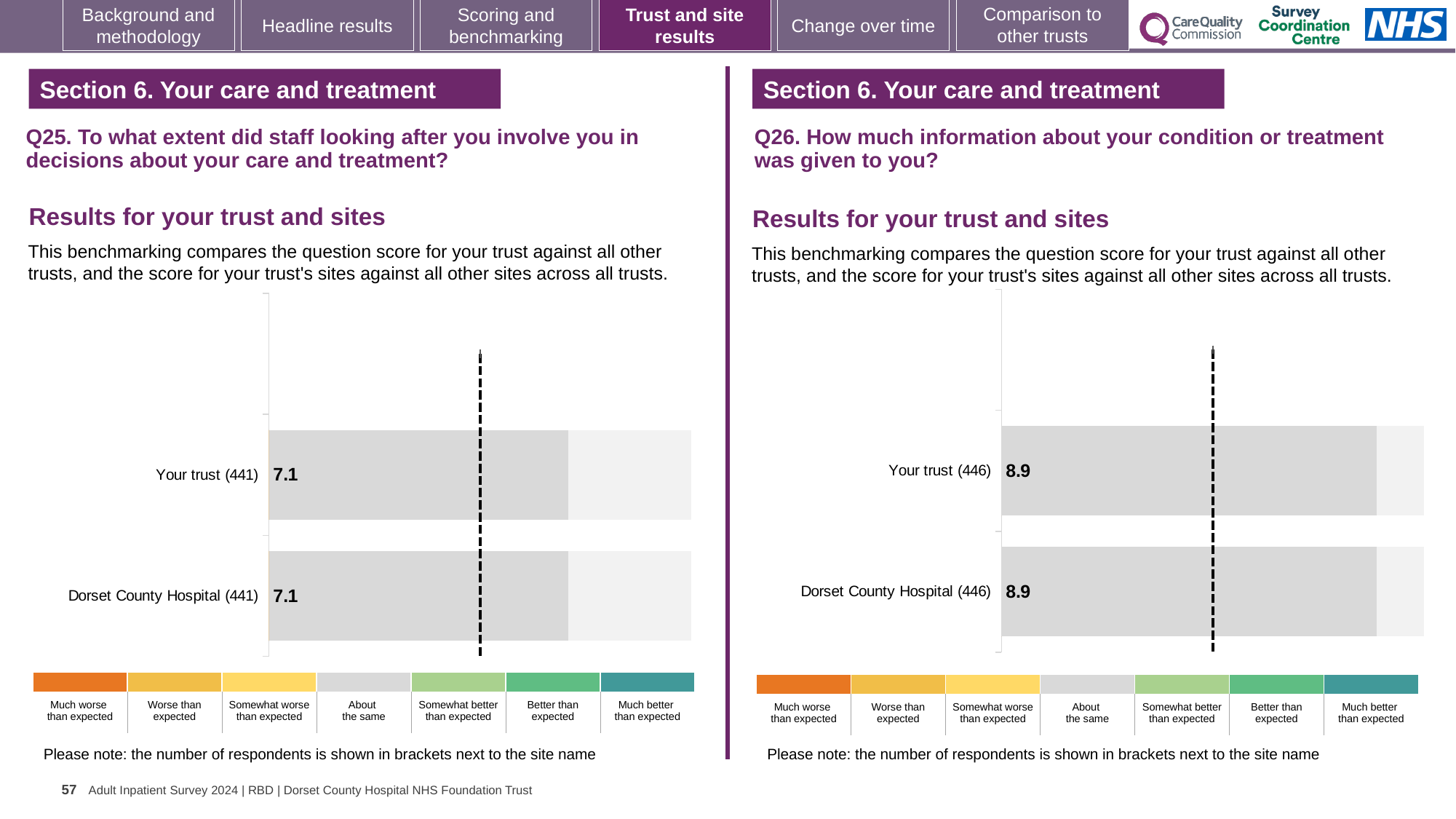
Is the score for Your trust in the Q26 chart on the right larger or smaller than the score for Your trust in the Q25 chart on the left? Larger In the Q25 chart on the left, what is the score for Your trust? 7.1 In the Q26 chart on the right, what is the difference between the score for Your trust and the score for Dorset County Hospital? 0 How many bars are plotted in the Q26 chart on the right? 2 In the Q26 chart on the right, what is the score for Dorset County Hospital? 8.9 In the Q26 chart on the right, how many respondents are shown in brackets next to Dorset County Hospital? 446 In the Q25 chart on the left, what is the difference between the score for Your trust and the score for Dorset County Hospital? 0 What kind of chart is the Q25 chart on the left? Bar chart In the Q26 chart on the right, what is the score for Your trust? 8.9 How many bars are plotted in the Q25 chart on the left? 2 In the Q25 chart on the left, what is the score for Dorset County Hospital? 7.1 In the Q25 chart on the left, how many respondents are shown in brackets next to Your trust? 441